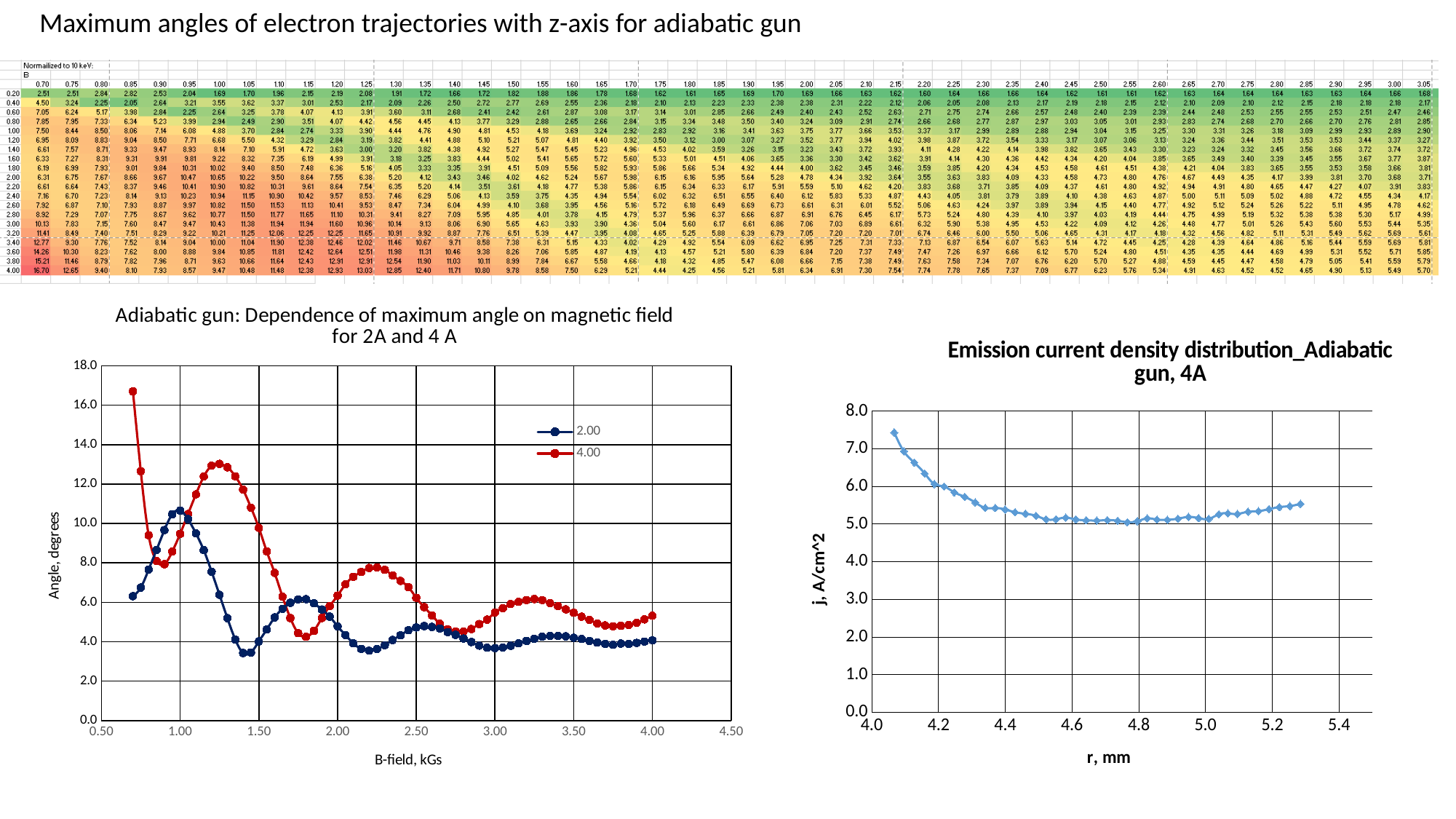
In the 'Adiabatic gun: Dependence of maximum angle on magnetic field' chart, which series has the higher value at B-field 4.00, 2.00 or 4.00? 4.00 What kind of chart is the 'Adiabatic gun: Dependence of maximum angle on magnetic field for 2A and 4 A' chart? line chart In the 'Adiabatic gun: Dependence of maximum angle on magnetic field' chart, is the value of the 2.00 series at B-field 0.70 greater or less than 8.0? less In the 'Emission current density distribution_Adiabatic gun, 4A' chart, is the value at the smallest r (about 4.07 mm) greater or less than 7.0? greater How many series does the legend of the 'Adiabatic gun: Dependence of maximum angle on magnetic field' chart list? 2 In the 'Emission current density distribution_Adiabatic gun, 4A' chart, does the current density rise or fall as r increases from 4.0 to 4.8 mm? fall What are the two legend entries in the 'Adiabatic gun: Dependence of maximum angle on magnetic field' chart? 2.00 and 4.00 In the 'Emission current density distribution_Adiabatic gun, 4A' chart, is the value at r = 5.2 mm greater or less than 6.0? less In the 'Adiabatic gun: Dependence of maximum angle on magnetic field' chart, which series has the higher value at B-field 1.25, 2.00 or 4.00? 4.00 In the 'Adiabatic gun: Dependence of maximum angle on magnetic field' chart, does the 4.00 series rise or fall between B-field 0.70 and 0.90? fall In the 'Adiabatic gun: Dependence of maximum angle on magnetic field' chart, what is the y-axis title? Angle, degrees